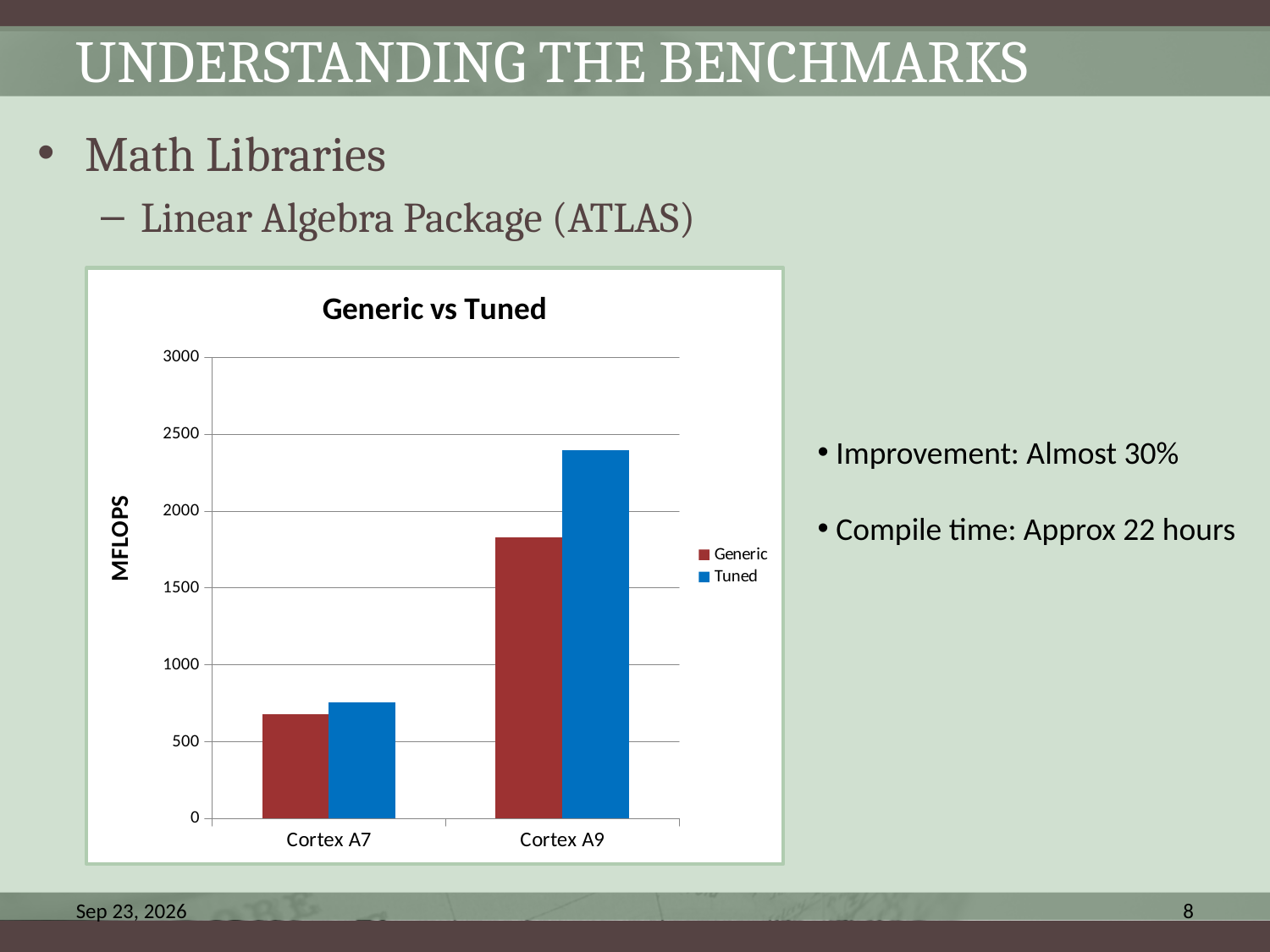
Is the Generic value for Cortex A9 greater or less than 1500? greater Is the Generic value for Cortex A9 greater or less than 2000? less Which bar in the chart is the lowest? Generic for Cortex A7 What is the label of the vertical axis of the chart? MFLOPS What kind of chart is shown on the slide? bar chart For Cortex A9, which is larger, the Generic value or the Tuned value? Tuned Is the Generic value for Cortex A7 greater or less than 1000? less What is the title of the chart? Generic vs Tuned Which bar in the chart is the highest? Tuned for Cortex A9 How many series does the chart legend list? 2 How many categories are shown on the x axis of the chart? 2